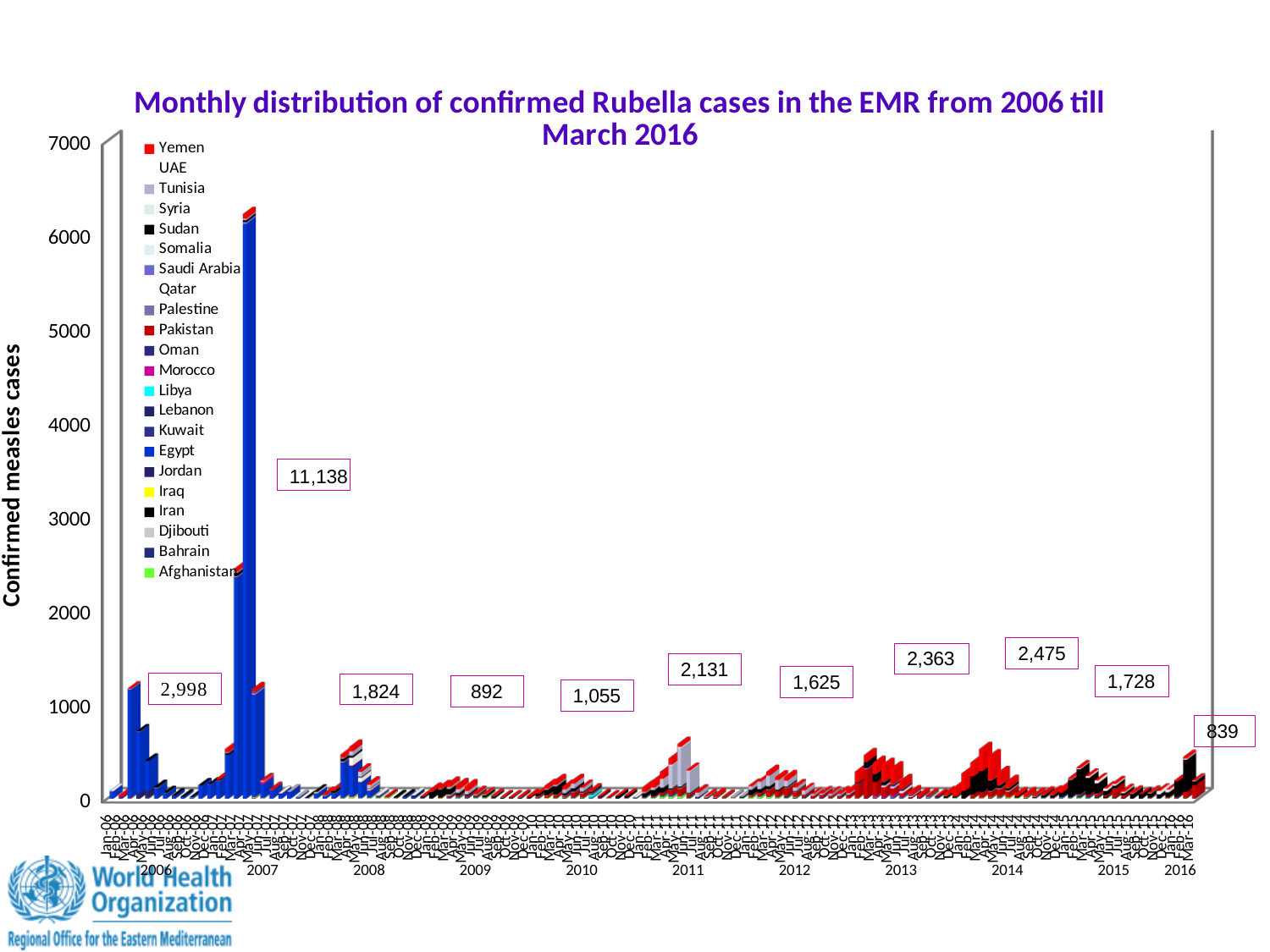
What is the annotated total of confirmed Rubella cases for 2014? 2,475 Which year has the larger annotated total, 2011 or 2012? 2011 Which year has the highest annotated total of confirmed Rubella cases? 2007 What is the difference between the annotated totals for 2007 and 2006? 8,140 How many countries are listed in the legend? 22 What is the annotated total of confirmed Rubella cases for 2016 (up to March)? 839 What is the annotated total of confirmed Rubella cases for 2007? 11,138 What kind of chart is shown on the slide? bar chart Among the full years 2006 to 2015, which year has the lowest annotated total? 2009 What is the difference between the annotated totals for 2014 and 2013? 112 Is the tallest monthly bar (in 2007) greater or less than 6000? greater What is the annotated total of confirmed Rubella cases for 2006? 2,998